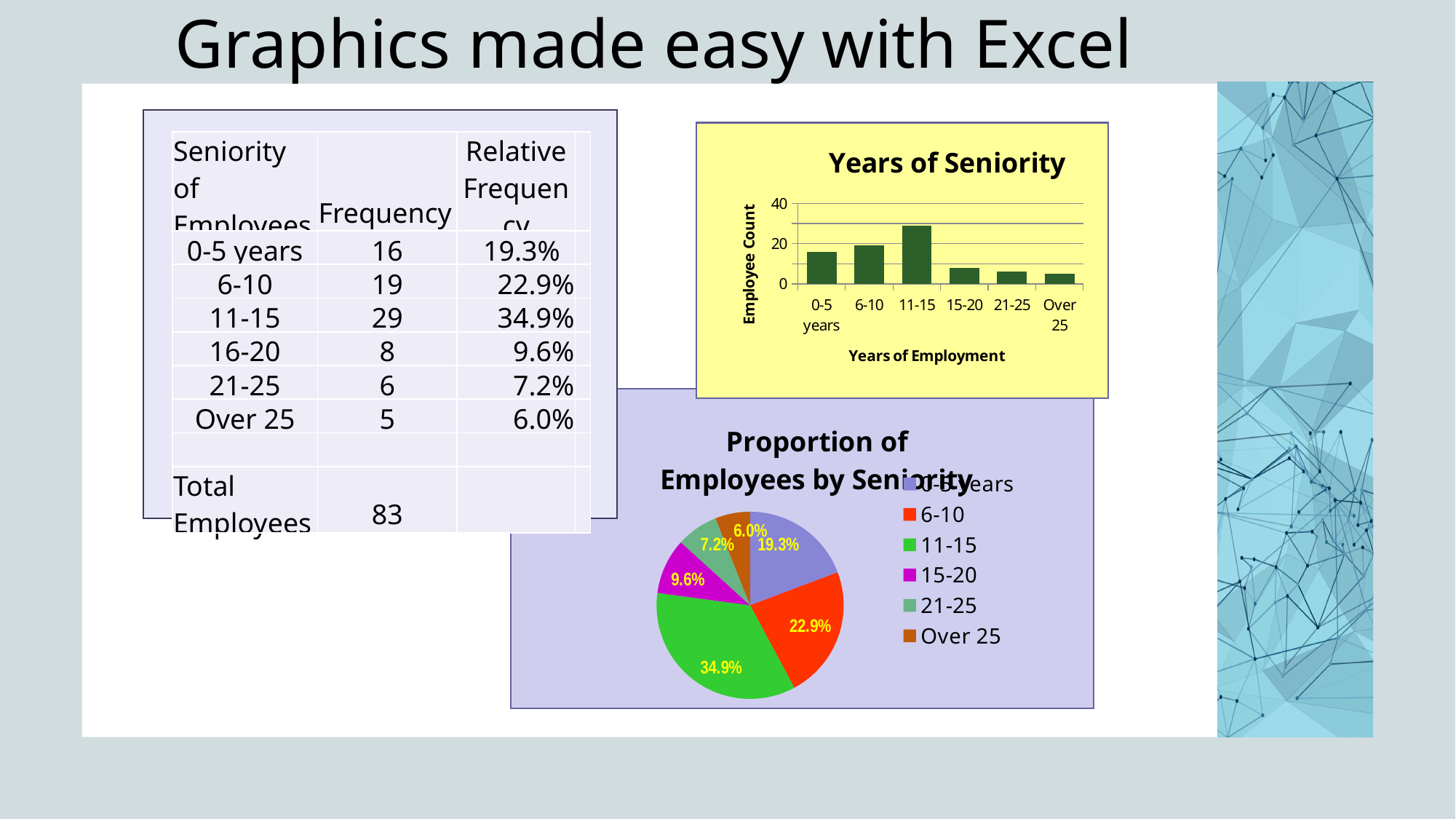
In the 'Proportion of Employees by Seniority' pie chart, which slice is the smallest? Over 25 In the 'Proportion of Employees by Seniority' pie chart, what share does the 11-15 slice have? 34.9% In the 'Years of Seniority' chart, is the value for 11-15 greater or less than 20? greater In the 'Proportion of Employees by Seniority' pie chart, which is larger, the 15-20 slice or the 21-25 slice? 15-20 What kind of chart is the 'Years of Seniority' chart? bar chart What kind of chart is the 'Proportion of Employees by Seniority' chart? pie chart In the 'Years of Seniority' chart, is the value for 0-5 years greater or less than 20? less How many categories are shown on the x axis of the 'Years of Seniority' chart? 6 In the 'Proportion of Employees by Seniority' pie chart, what is the value labelled on the 6-10 slice? 22.9% In the 'Proportion of Employees by Seniority' pie chart, what is the difference between the 11-15 share and the 6-10 share? 12.0% What is the title of the vertical axis in the 'Years of Seniority' chart? Employee Count In the 'Years of Seniority' chart, which category has the highest employee count? 11-15